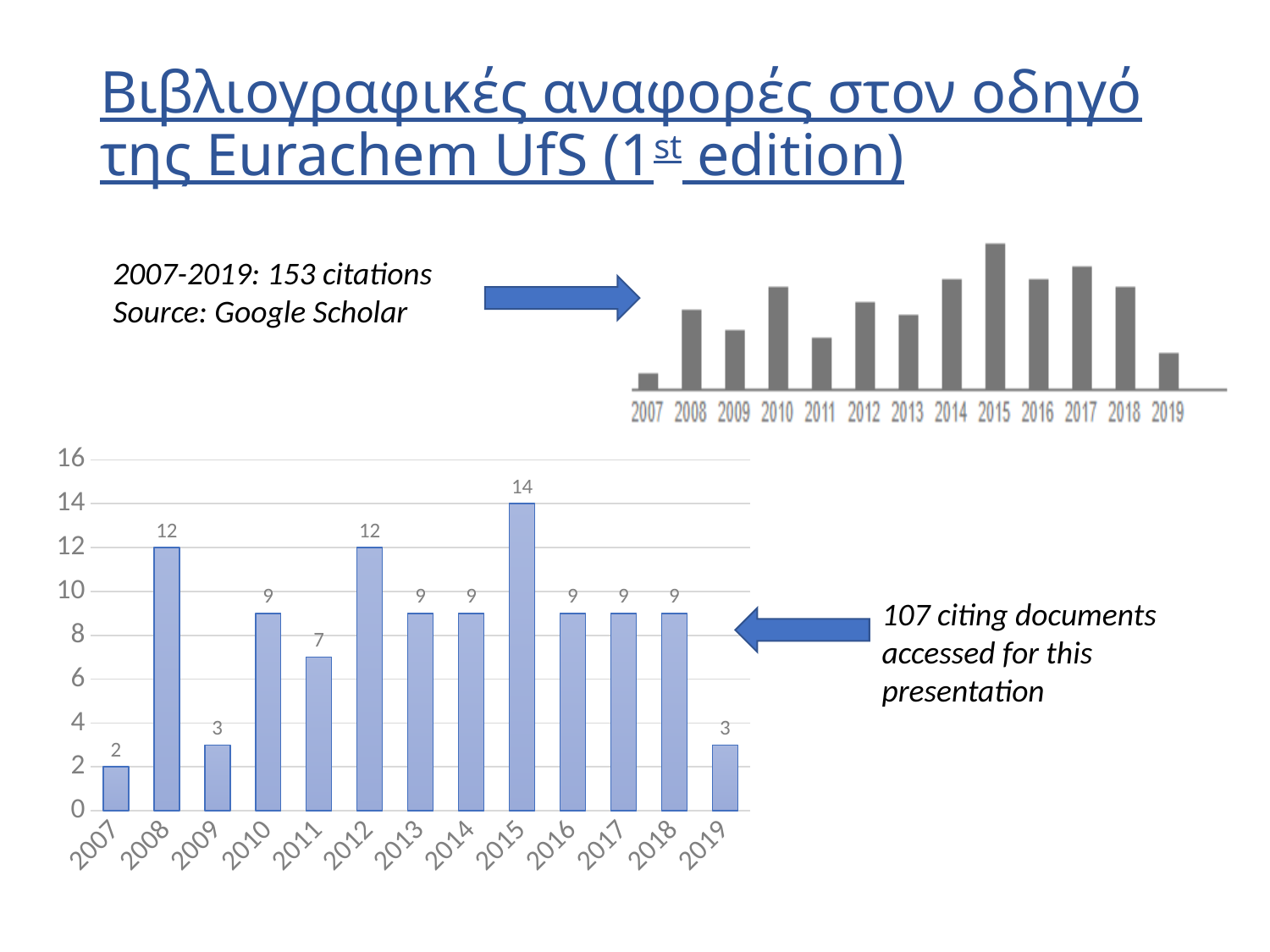
What kind of chart is the bottom-left chart? Bar chart In the bottom-left bar chart, which year has the highest value? 2015 In the top-right grey bar chart, which year has the tallest bar? 2015 In the bottom-left bar chart, what is the difference between the values for 2015 and 2008? 2 In the bottom-left bar chart, which year has the lowest value? 2007 In the bottom-left bar chart, what is the value for 2011? 7 In the top-right grey bar chart, how many years are shown on the x axis? 13 In the bottom-left bar chart, is the value for 2012 greater or less than 10? greater In the bottom-left bar chart, which is larger, the value for 2010 or the value for 2011? 2010 In the bottom-left bar chart, what is the value for 2015? 14 In the top-right grey bar chart, which year has the shortest bar? 2007 In the bottom-left bar chart, how many years are shown on the x axis? 13